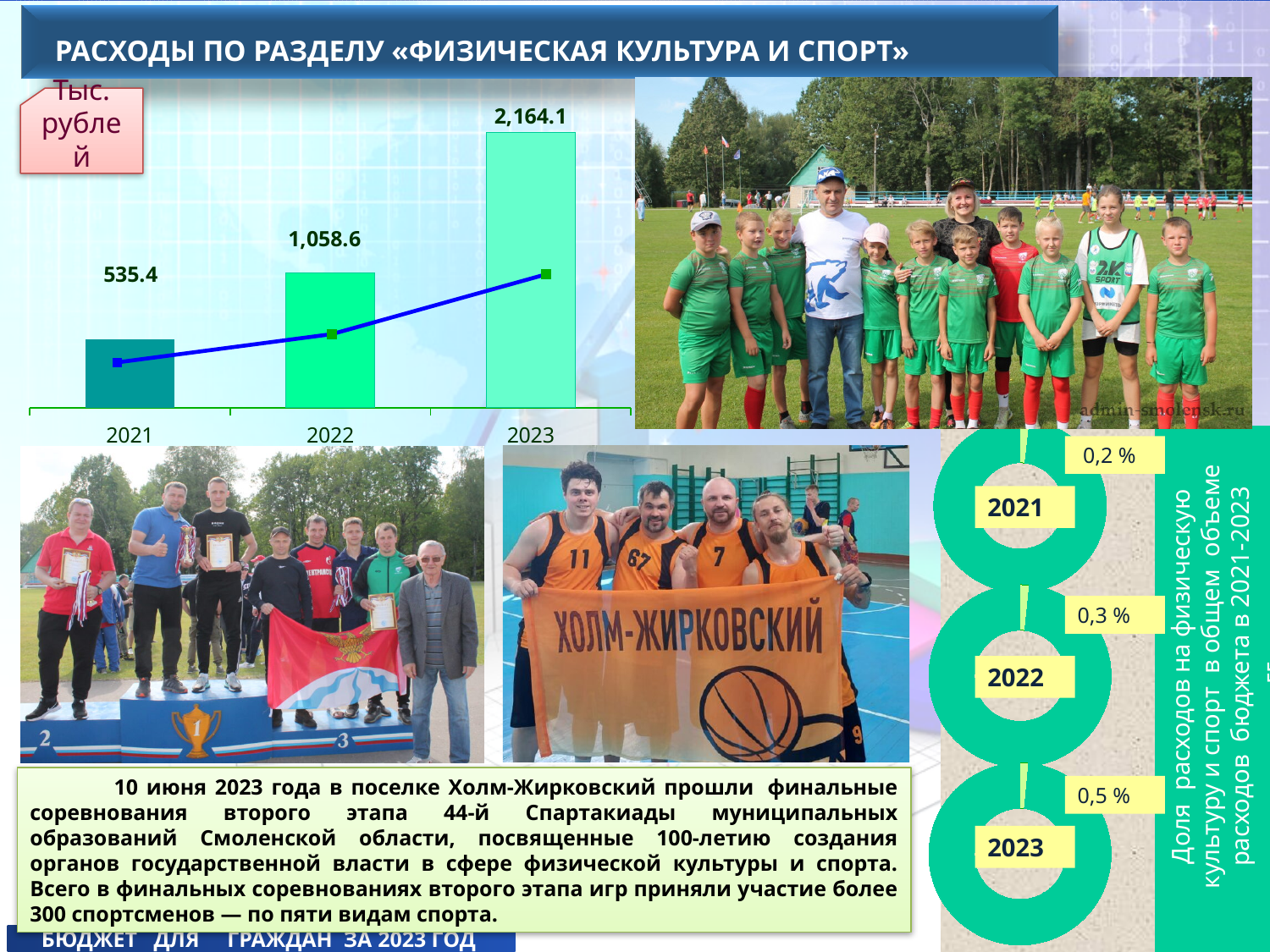
In the bar chart, which year has the highest value? 2023 In the bar chart, which year has the lowest value? 2021 In the bar chart, which is larger, the value for 2021 or the value for 2022? 2022 In the bar chart, what is the value for 2022? 1,058.6 How many years are shown on the x axis of the bar chart? 3 In the bar chart, what is the difference between the values for 2023 and 2022? 1,105.5 In the share graphic on the right of the slide, what is the share shown for 2023? 0,5 % What kind of chart is shown in the top left of the slide? bar chart In the bar chart, do the values rise or fall from 2021 to 2023? rise In the bar chart, what is the value for 2023? 2,164.1 In the bar chart, what is the value for 2021? 535.4 In the bar chart, what is the difference between the values for 2022 and 2021? 523.2